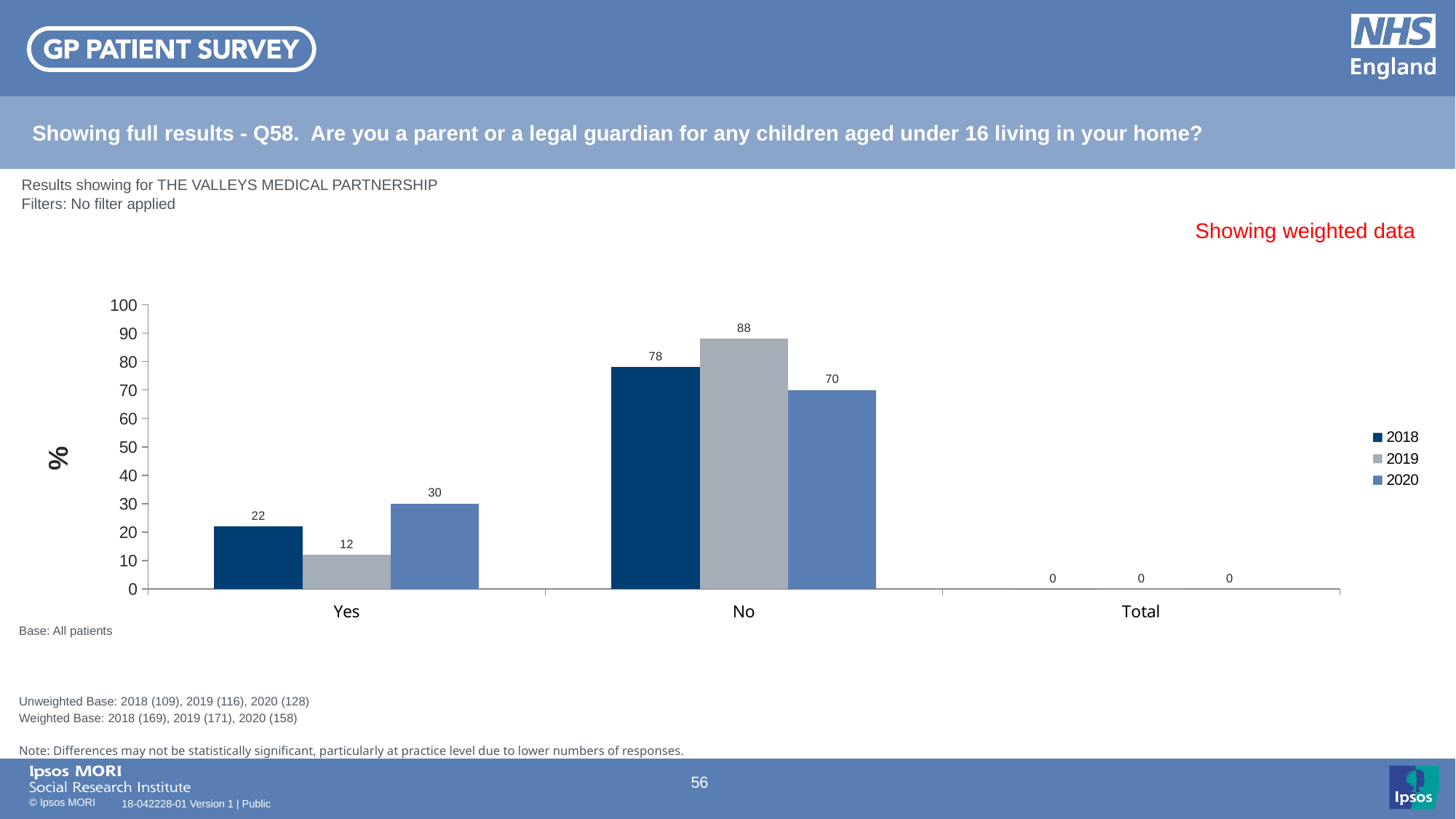
What is the value for 'Yes' in 2018? 22 Which year has the lowest value for 'Yes'? 2019 What is the value for 'No' in 2020? 70 How many series does the legend list? 3 Which year has the highest value for 'No'? 2019 What is the value for 'No' in 2019? 88 What is the value for 'Yes' in 2020? 30 What is the difference between the 2019 and 2020 values for 'No'? 18 What kind of chart is shown on the slide? Bar chart How many categories are shown on the x axis? 3 Which is larger: the 2018 value for 'Yes' or the 2020 value for 'Yes'? 2020 What is the label on the y axis? %